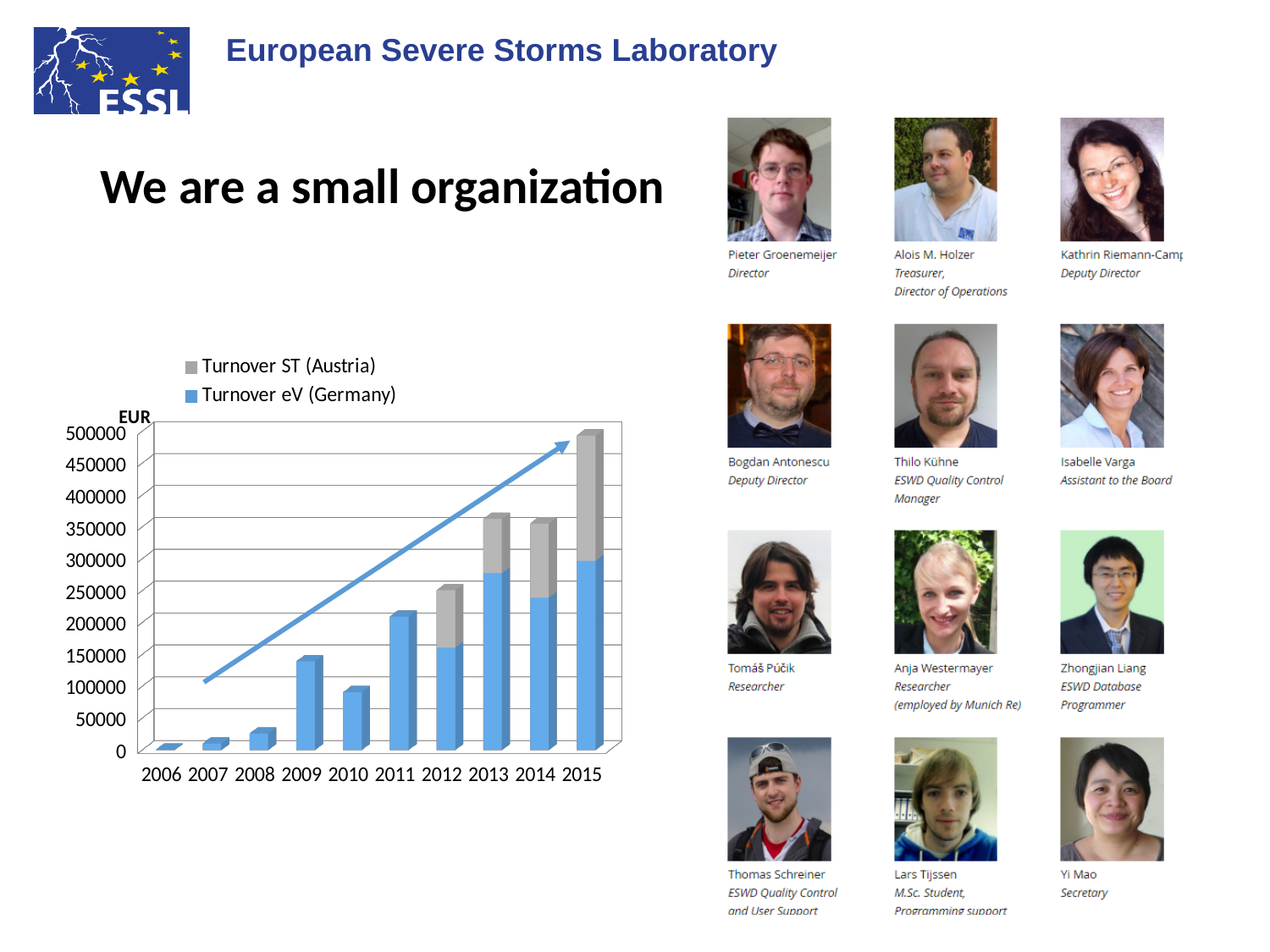
What kind of chart is shown on the slide? Stacked bar chart Which year has the highest total turnover in the chart? 2015 Does the total turnover generally rise or fall from 2006 to 2015? Rise What unit label is shown on the vertical axis of the turnover chart? EUR Which series is shown in grey in the turnover chart? Turnover ST (Austria) Is the total turnover for 2008 greater or less than 50000? less Is the total turnover for 2014 greater or less than 300000? greater Which year has the larger total turnover, 2011 or 2012? 2012 How many series does the legend of the turnover chart list? 2 Is the total turnover for 2010 greater or less than 150000? less How many years are shown on the x axis of the turnover chart? 10 Which year has the lowest total turnover in the chart? 2006